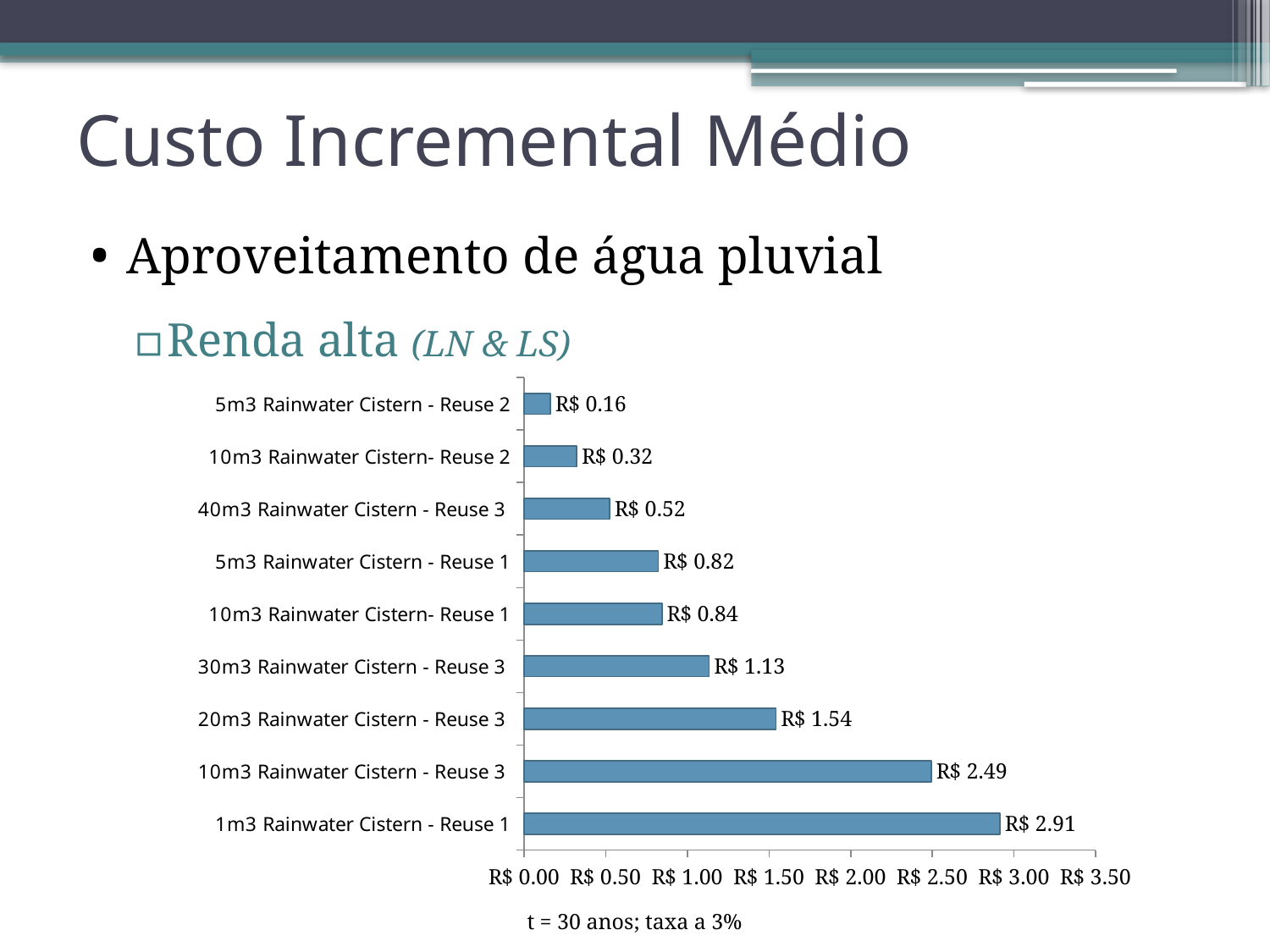
What is the value for 1m3 Rainwater Cistern - Reuse 1? R$ 2.91 What is the value for 20m3 Rainwater Cistern - Reuse 3? R$ 1.54 Which category has the lowest value? 5m3 Rainwater Cistern - Reuse 2 Which category has the highest value? 1m3 Rainwater Cistern - Reuse 1 Is the value for 10m3 Rainwater Cistern - Reuse 3 greater or less than R$ 2.00? greater What note is printed below the chart's x axis? t = 30 anos; taxa a 3% What is the difference between the values for 10m3 Rainwater Cistern - Reuse 3 and 30m3 Rainwater Cistern - Reuse 3? R$ 1.36 How many categories are shown in the chart? 9 Which is larger, the value for 40m3 Rainwater Cistern - Reuse 3 or the value for 10m3 Rainwater Cistern- Reuse 2? 40m3 Rainwater Cistern - Reuse 3 What is the difference between the values for 10m3 Rainwater Cistern- Reuse 1 and 5m3 Rainwater Cistern - Reuse 1? R$ 0.02 What kind of chart is shown on the slide? bar chart What is the value for 5m3 Rainwater Cistern - Reuse 2? R$ 0.16